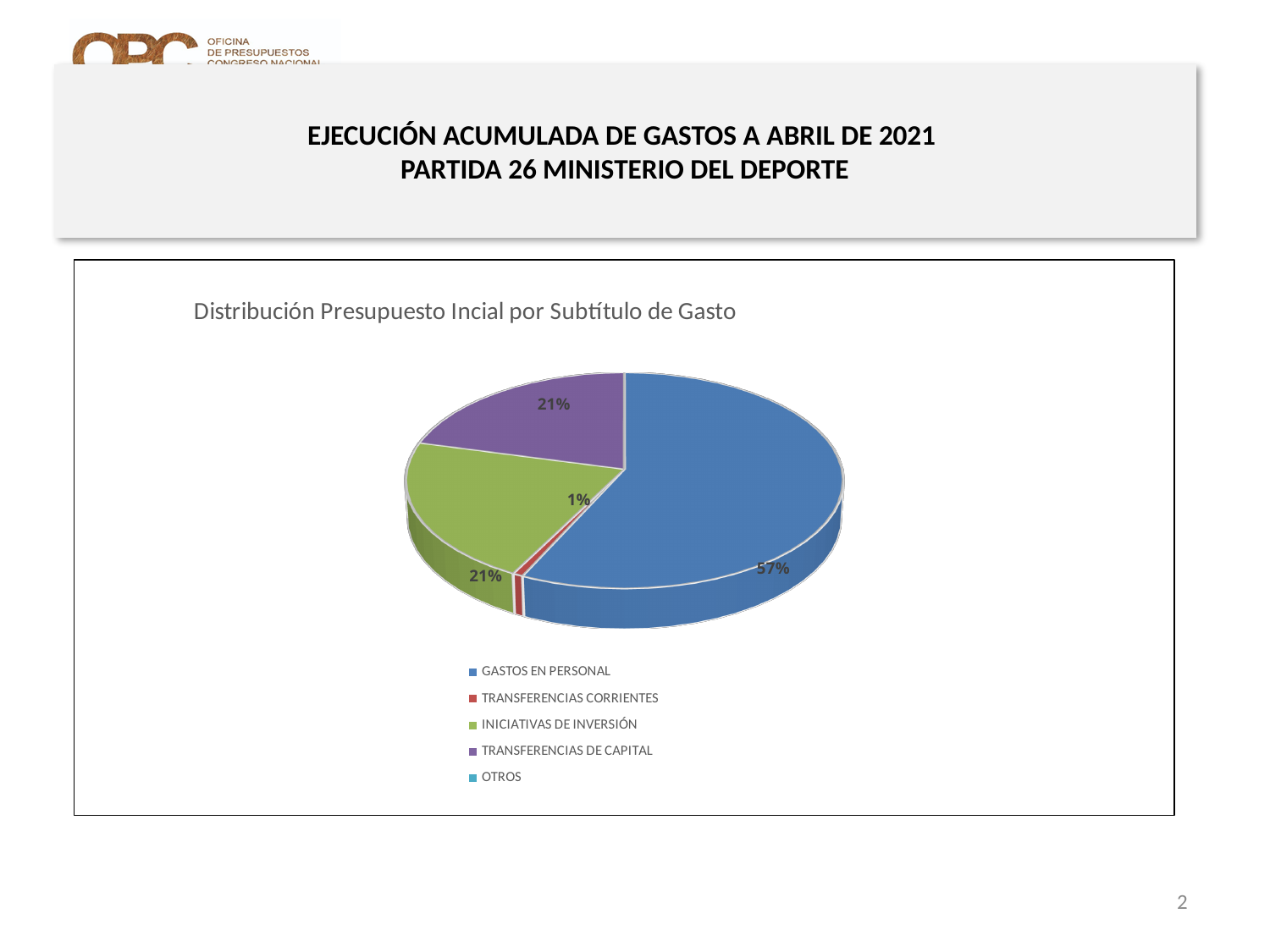
Which slice is larger, GASTOS EN PERSONAL or TRANSFERENCIAS DE CAPITAL? GASTOS EN PERSONAL What is the title of the chart? Distribución Presupuesto Incial por Subtítulo de Gasto What kind of chart is shown on the slide? Pie chart What share of the pie does TRANSFERENCIAS CORRIENTES represent? 1% Is the share for GASTOS EN PERSONAL greater or less than 50%? greater What is the difference in percentage points between the GASTOS EN PERSONAL slice and the TRANSFERENCIAS DE CAPITAL slice? 36 percentage points What share of the pie does INICIATIVAS DE INVERSIÓN represent? 21% How many categories does the legend list? 5 What share of the pie does GASTOS EN PERSONAL represent? 57% Which category has the largest slice of the pie? GASTOS EN PERSONAL Which slice is larger, TRANSFERENCIAS CORRIENTES or INICIATIVAS DE INVERSIÓN? INICIATIVAS DE INVERSIÓN